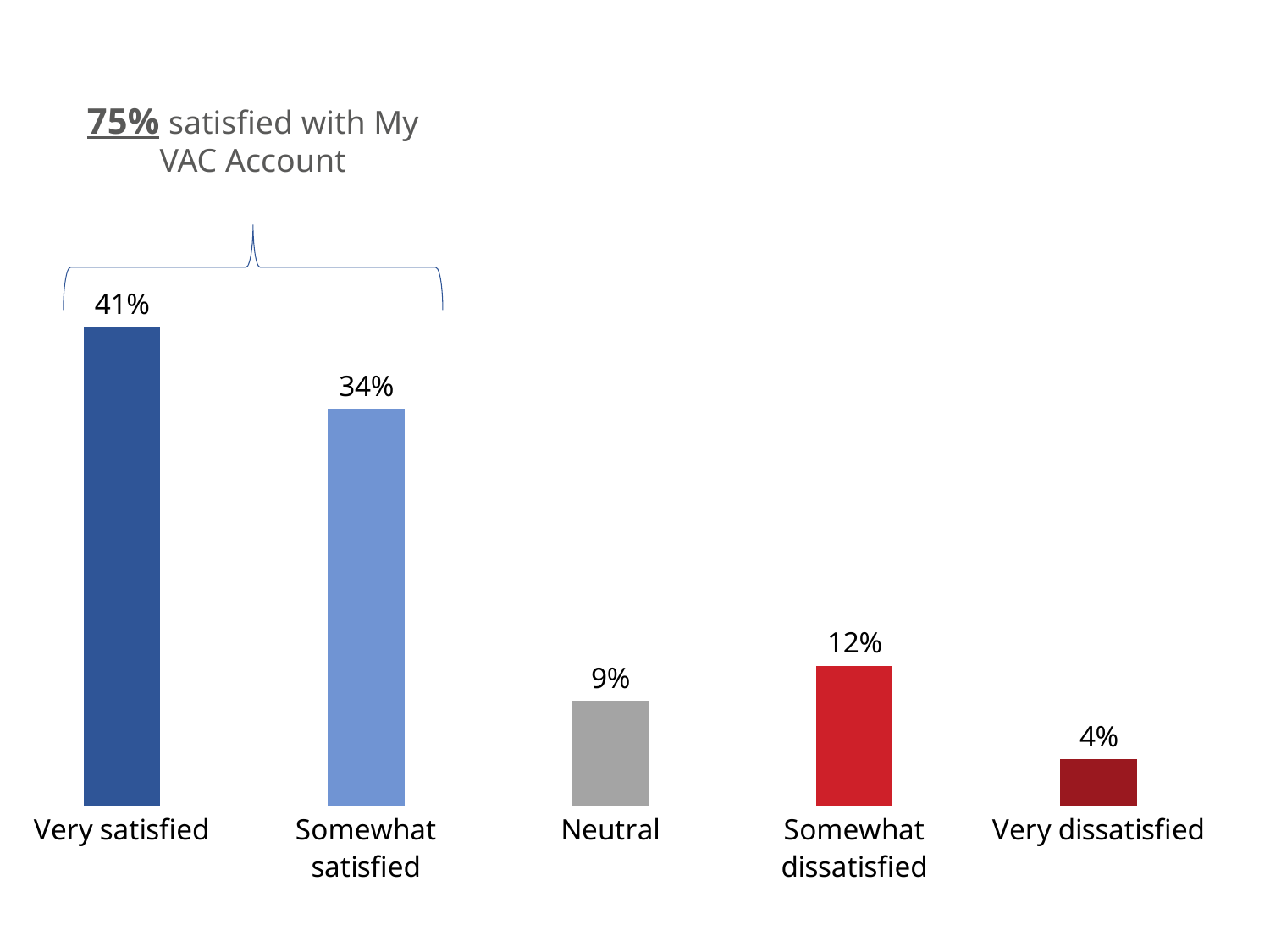
Which category has the highest value? Very satisfied What is the difference between the values for Very satisfied and Somewhat satisfied? 7% Which category has the lowest value? Very dissatisfied Which is larger, the value for Neutral or the value for Somewhat dissatisfied? Somewhat dissatisfied What kind of chart is shown on the slide? Bar chart What is the value for Somewhat satisfied? 34% How many categories are shown in the chart? 5 What is the value for Very satisfied? 41% What is the value for Somewhat dissatisfied? 12% What is the value for Very dissatisfied? 4% What is the difference between the values for Somewhat dissatisfied and Neutral? 3% What is the value for Neutral? 9%